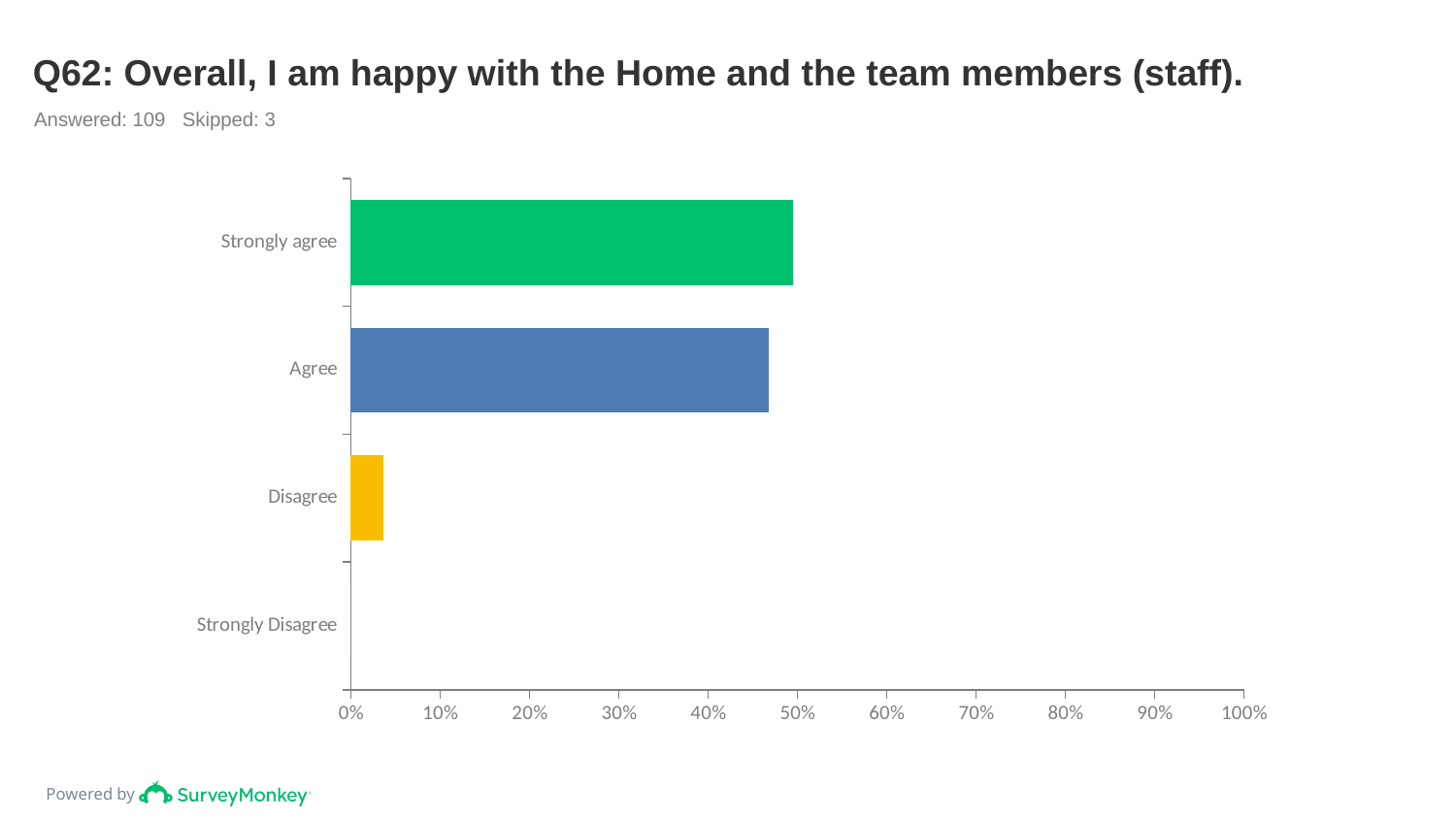
Is the value for Agree greater or less than 50%? less How many respondents answered this question according to the slide? 109 Is the value for Strongly agree greater or less than 40%? greater Is the value for Agree greater or less than 40%? greater Which is larger, the value for Agree or the value for Disagree? Agree How many response categories are shown on the chart? 4 What is the title of the chart? Q62: Overall, I am happy with the Home and the team members (staff). Which response category has the lowest value on the chart? Strongly Disagree What is the value for Strongly Disagree? 0% What kind of chart is shown on the slide? bar chart